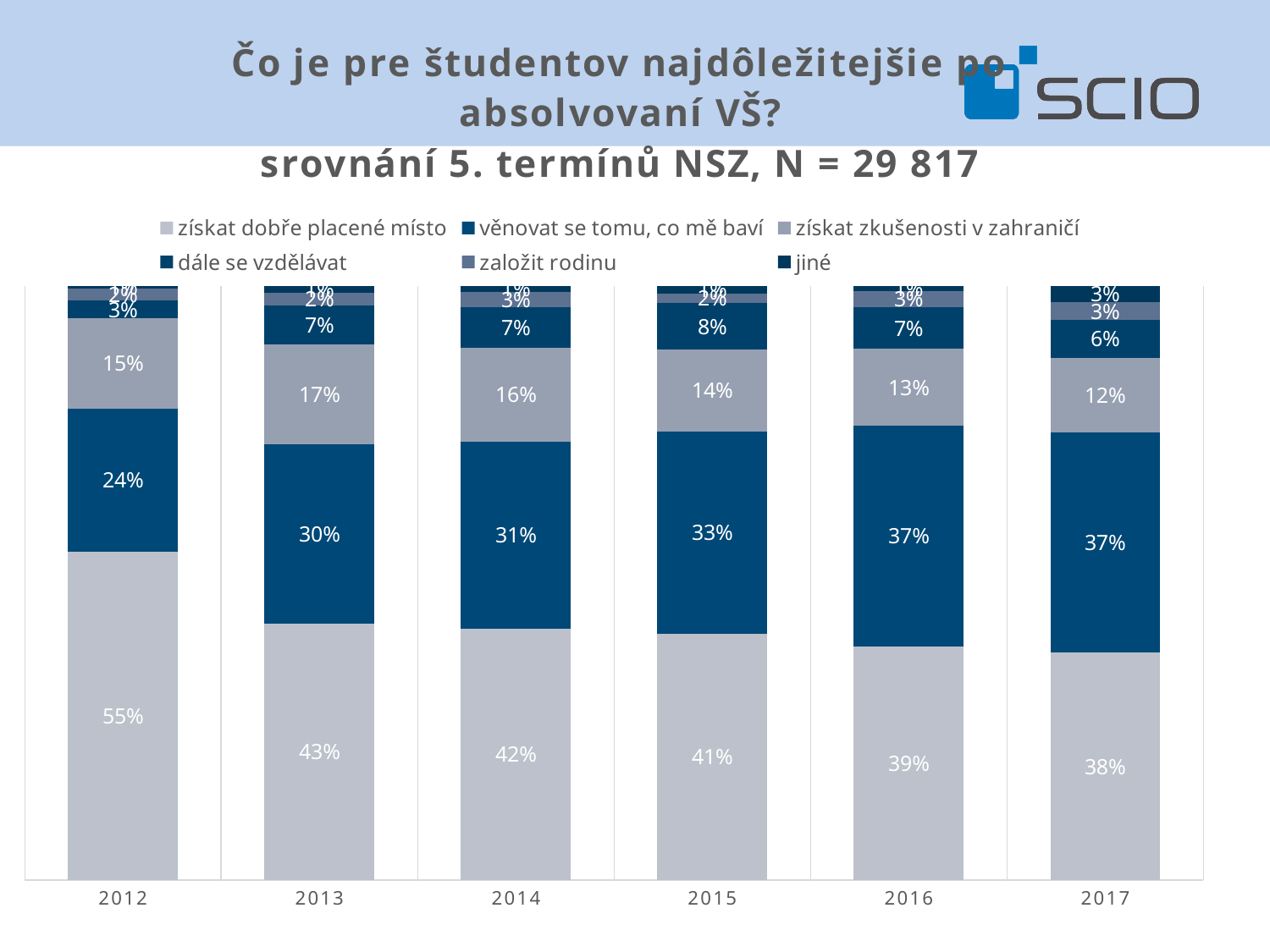
How many years are shown on the x axis of the chart? 6 What kind of chart is shown on the slide? stacked bar chart What is the value for 'dále se vzdělávat' in 2015? 8% How many series does the legend list? 6 In which year is the value for 'získat dobře placené místo' the lowest? 2017 What is the difference between the 'získat dobře placené místo' values in 2012 and 2017? 17% What is the value for 'získat zkušenosti v zahraničí' in 2013? 17% Does the value for 'věnovat se tomu, co mě baví' generally rise or fall from 2012 to 2017? rise What is the value for 'získat dobře placené místo' in 2012? 55% Which is larger in 2014: 'získat dobře placené místo' or 'věnovat se tomu, co mě baví'? získat dobře placené místo What is the value for 'věnovat se tomu, co mě baví' in 2016? 37% In which year is the value for 'získat zkušenosti v zahraničí' the highest? 2013